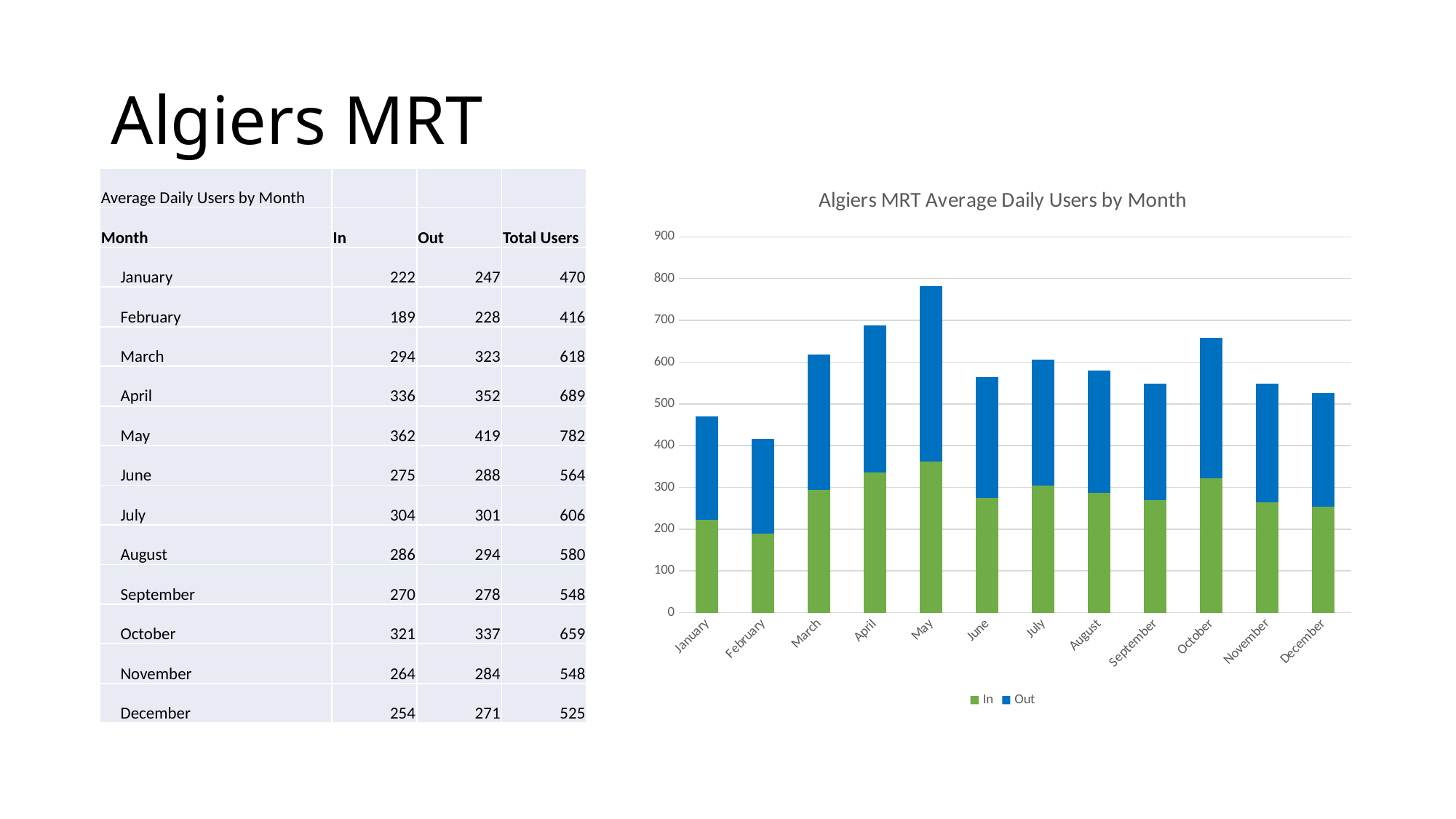
What is the total height of the stacked bar for December (In plus Out)? 525 What is the difference between the Out value and the In value for May? 57 Which colour represents the In series in the chart? green What is the Out value for October? 337 Is the total stacked bar for May greater or less than 700? greater Which month has a taller stacked bar, October or March? October What kind of chart is shown on the slide? bar chart What is the In value for May? 362 How many months are plotted along the x axis of the chart? 12 Which month has the shortest stacked bar in the chart? February How many series does the chart legend list? 2 Which month has the tallest stacked bar in the chart? May